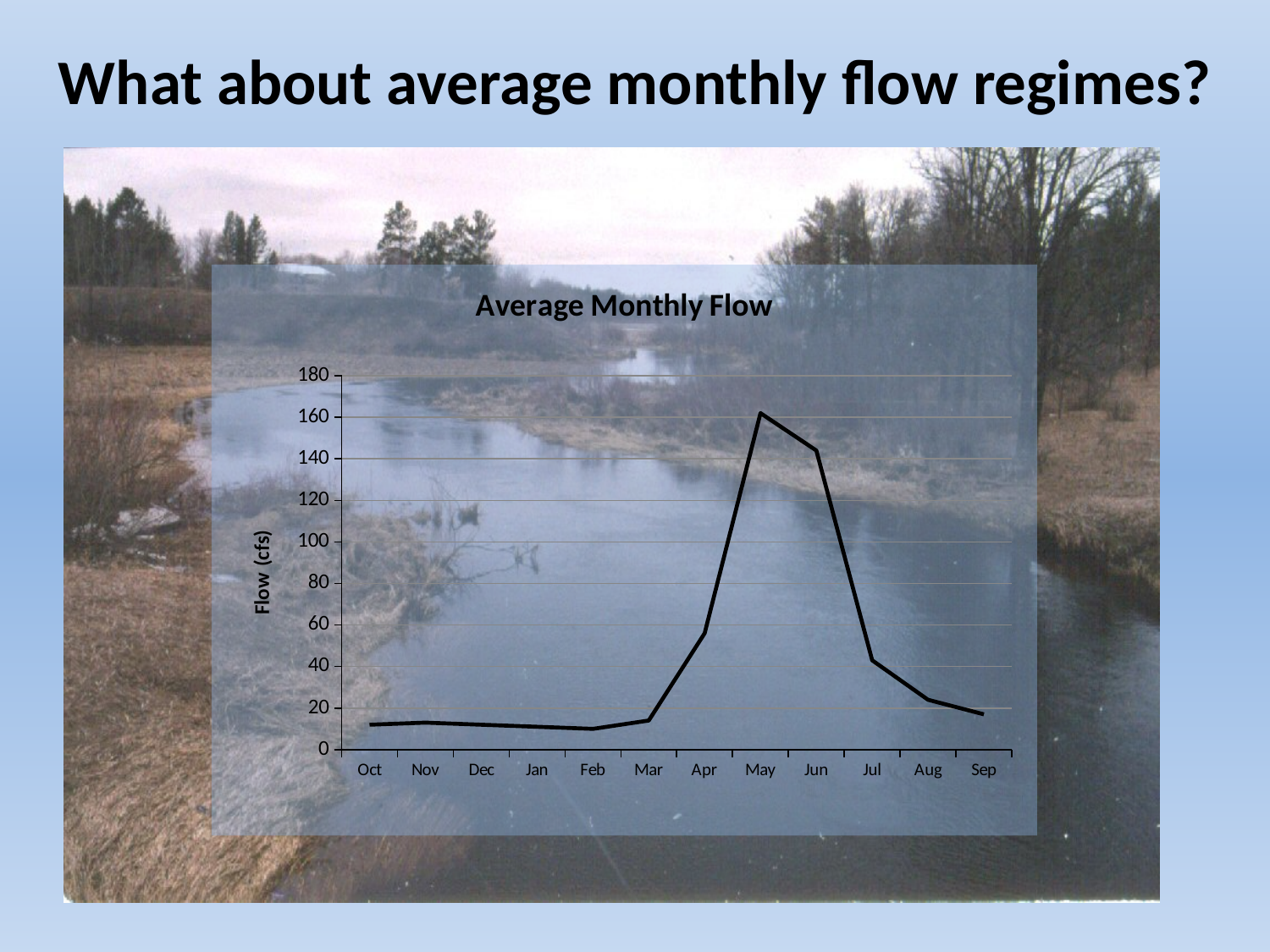
Do the values rise or fall from May to Sep? fall Is the value for Oct greater or less than 20? less Is the value for Jun greater or less than 120? greater What is the title of the chart? Average Monthly Flow Which is larger, the flow in Apr or the flow in Jul? Apr Which month has the highest average flow? May What kind of chart is shown on the slide? line chart Is the value for Jul greater or less than 60? less Which is larger, the flow in May or the flow in Jun? May How many months are plotted along the x axis? 12 What is the label of the vertical axis? Flow (cfs)